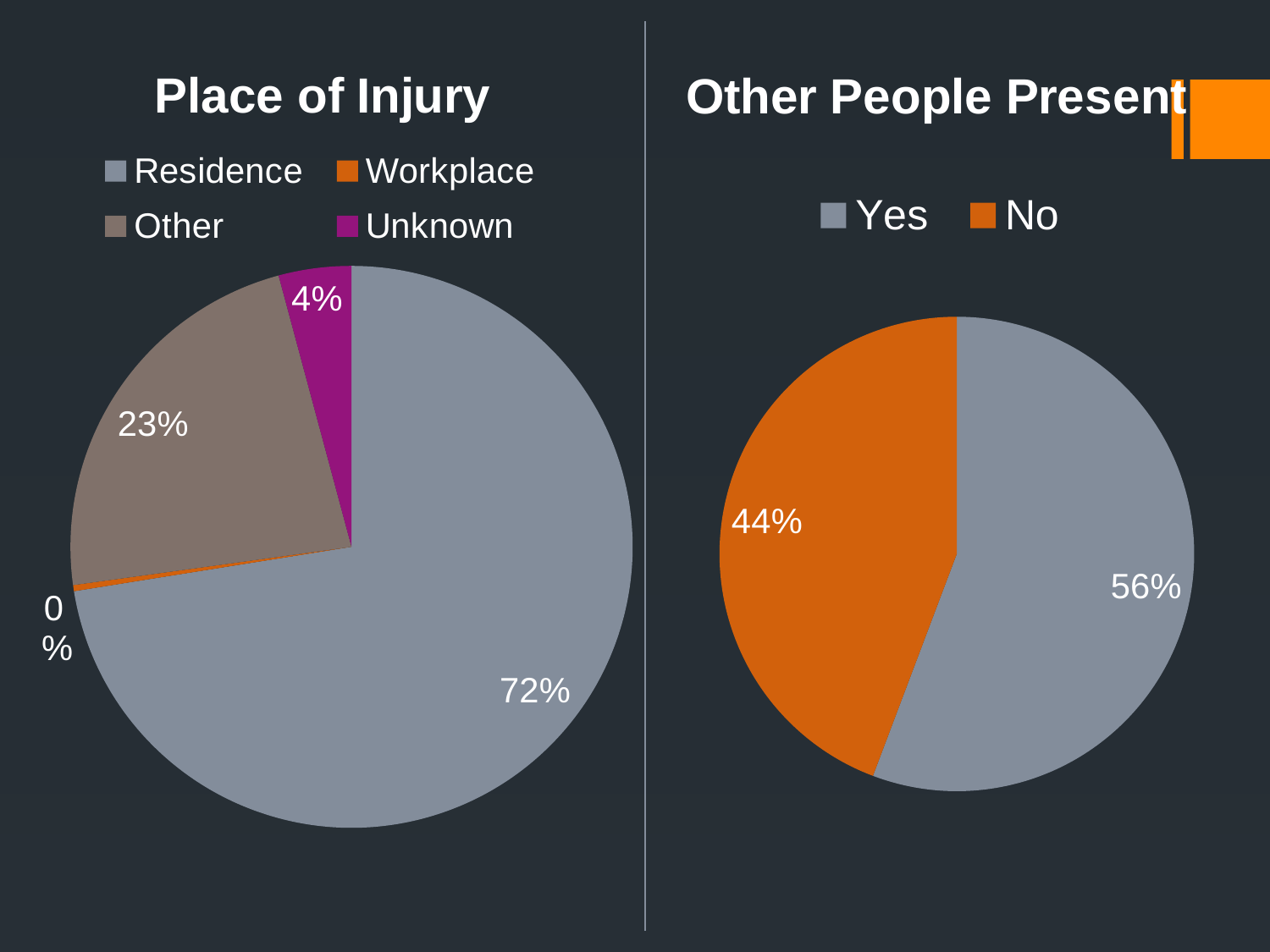
In the 'Place of Injury' chart, how many categories does the legend list? 4 In the 'Other People Present' chart, what percentage is shown for 'No'? 44% In the 'Place of Injury' chart, what share of injuries occurred at a residence? 72% In the 'Place of Injury' chart, what percentage is shown for 'Workplace'? 0% In the 'Place of Injury' chart, which category has the largest slice? Residence In the 'Place of Injury' chart, which category has the smallest slice? Workplace In the 'Other People Present' chart, what percentage is shown for 'Yes'? 56% In the 'Place of Injury' chart, what percentage is shown for 'Unknown'? 4% In the 'Place of Injury' chart, what percentage is labelled for 'Other'? 23% In the 'Place of Injury' chart, what is the difference between the Residence and Other shares? 49% In the 'Other People Present' chart, which is larger, 'Yes' or 'No'? Yes What kind of chart is the 'Other People Present' chart? Pie chart